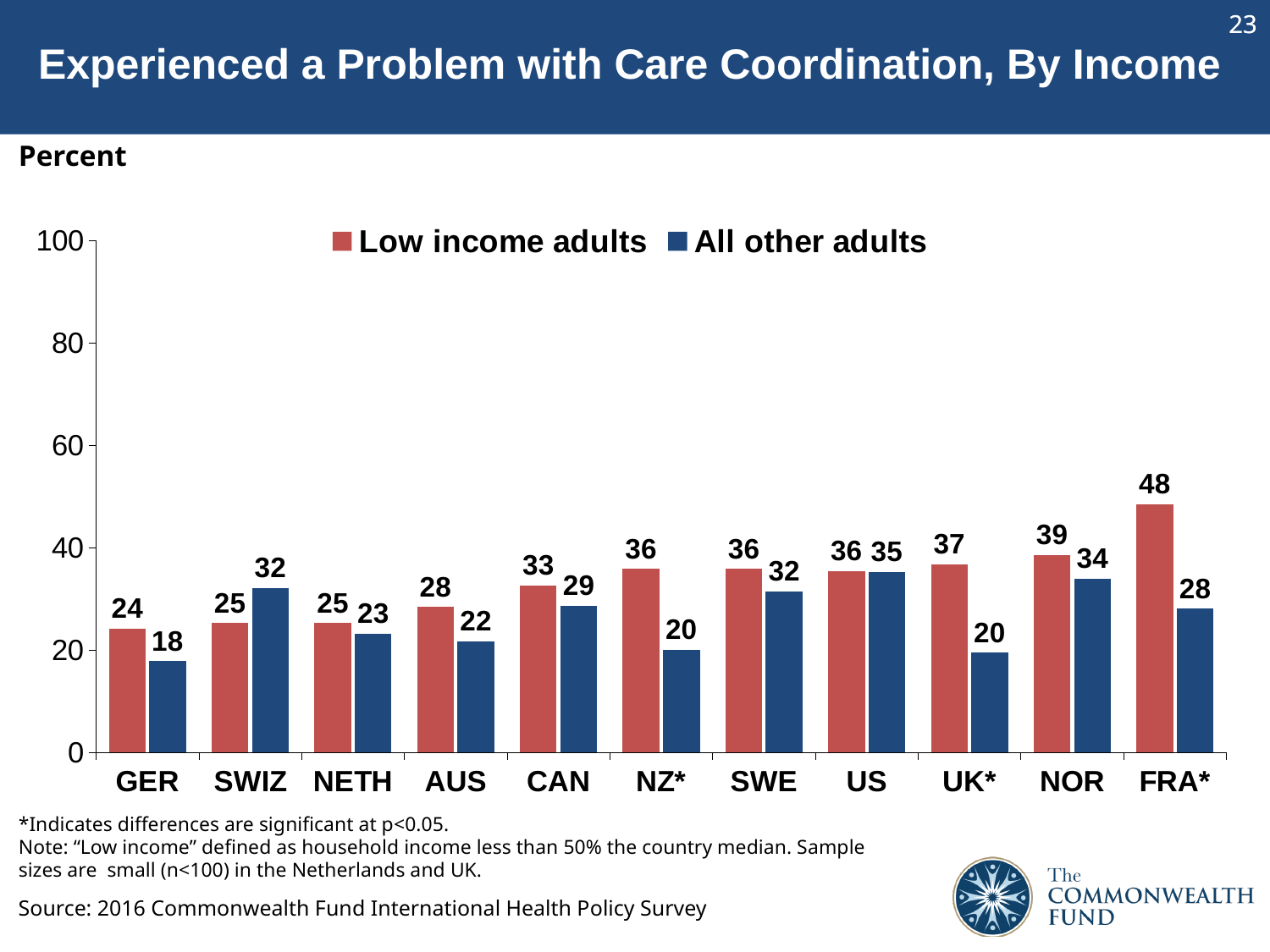
Which is larger in SWIZ: Low income adults or All other adults? All other adults How many series does the legend list? 2 What is the value for All other adults in GER? 18 How many countries are shown on the x axis? 11 What is the title of the chart? Experienced a Problem with Care Coordination, By Income What is the difference between Low income adults and All other adults in FRA*? 20 Which country has the highest value for Low income adults? FRA* What is the value for Low income adults in FRA*? 48 Which country has the lowest value for All other adults? GER What kind of chart is shown on the slide? Bar chart What is the value for All other adults in NZ*? 20 What is the difference between Low income adults and All other adults in UK*? 17